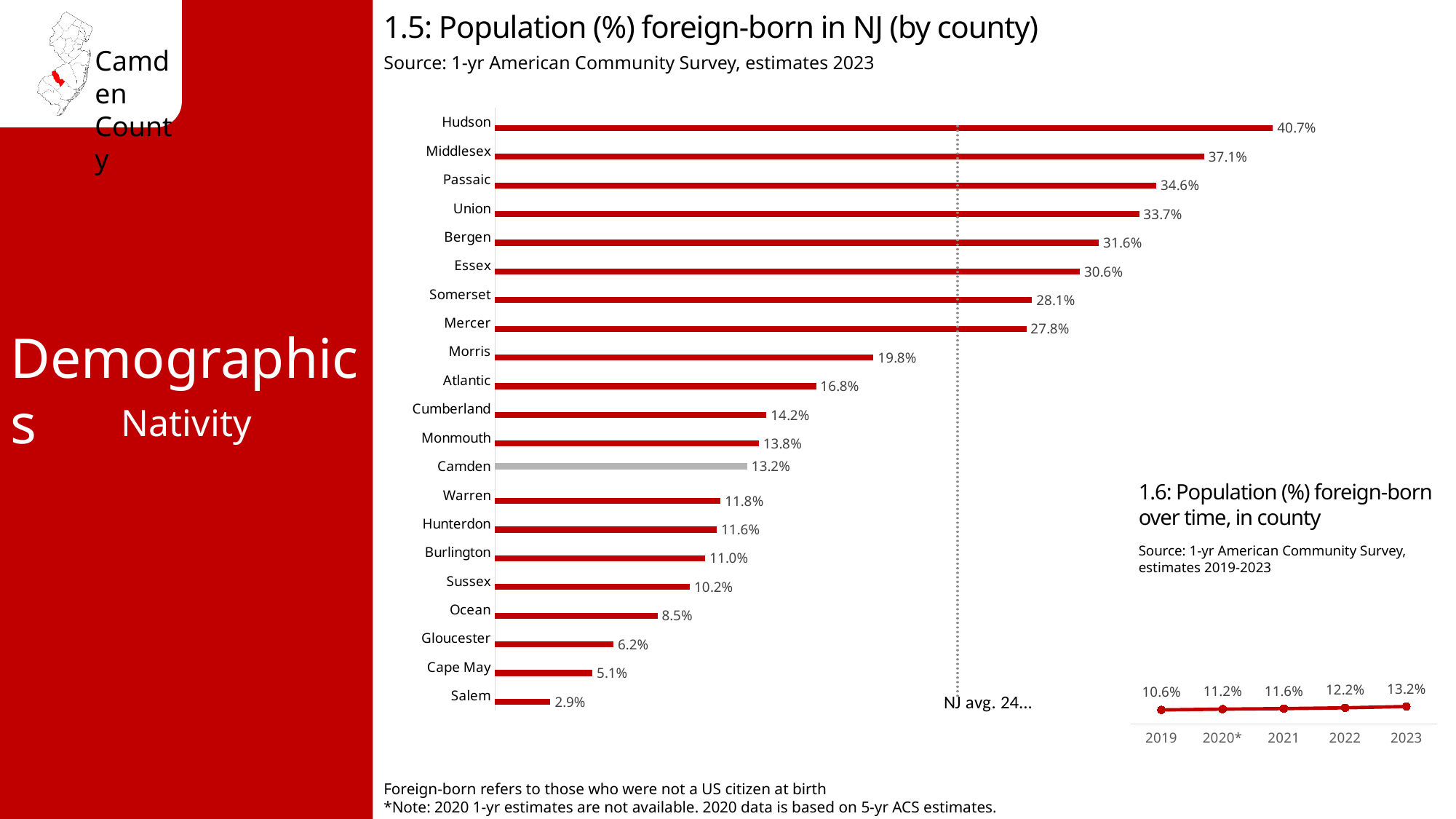
In chart 1.5 (Population (%) foreign-born in NJ by county), which county has the lowest value? Salem In chart 1.5 (Population (%) foreign-born in NJ by county), which is larger, Morris or Atlantic? Morris In chart 1.6 (Population (%) foreign-born over time, in county), do the values rise or fall from 2019 to 2023? Rise In chart 1.5 (Population (%) foreign-born in NJ by county), which county's bar is coloured grey instead of red? Camden In chart 1.5 (Population (%) foreign-born in NJ by county), how many counties are shown? 21 What kind of chart is chart 1.5 (Population (%) foreign-born in NJ by county)? Bar chart In chart 1.6 (Population (%) foreign-born over time, in county), what is the value for 2019? 10.6% In chart 1.5 (Population (%) foreign-born in NJ by county), what is the difference between Middlesex and Passaic? 2.5% In chart 1.6 (Population (%) foreign-born over time, in county), what is the difference between 2023 and 2019? 2.6% In chart 1.5 (Population (%) foreign-born in NJ by county), which county has the highest value? Hudson In chart 1.5 (Population (%) foreign-born in NJ by county), what is the value for Hudson? 40.7% In chart 1.5 (Population (%) foreign-born in NJ by county), what is the value for Camden? 13.2%